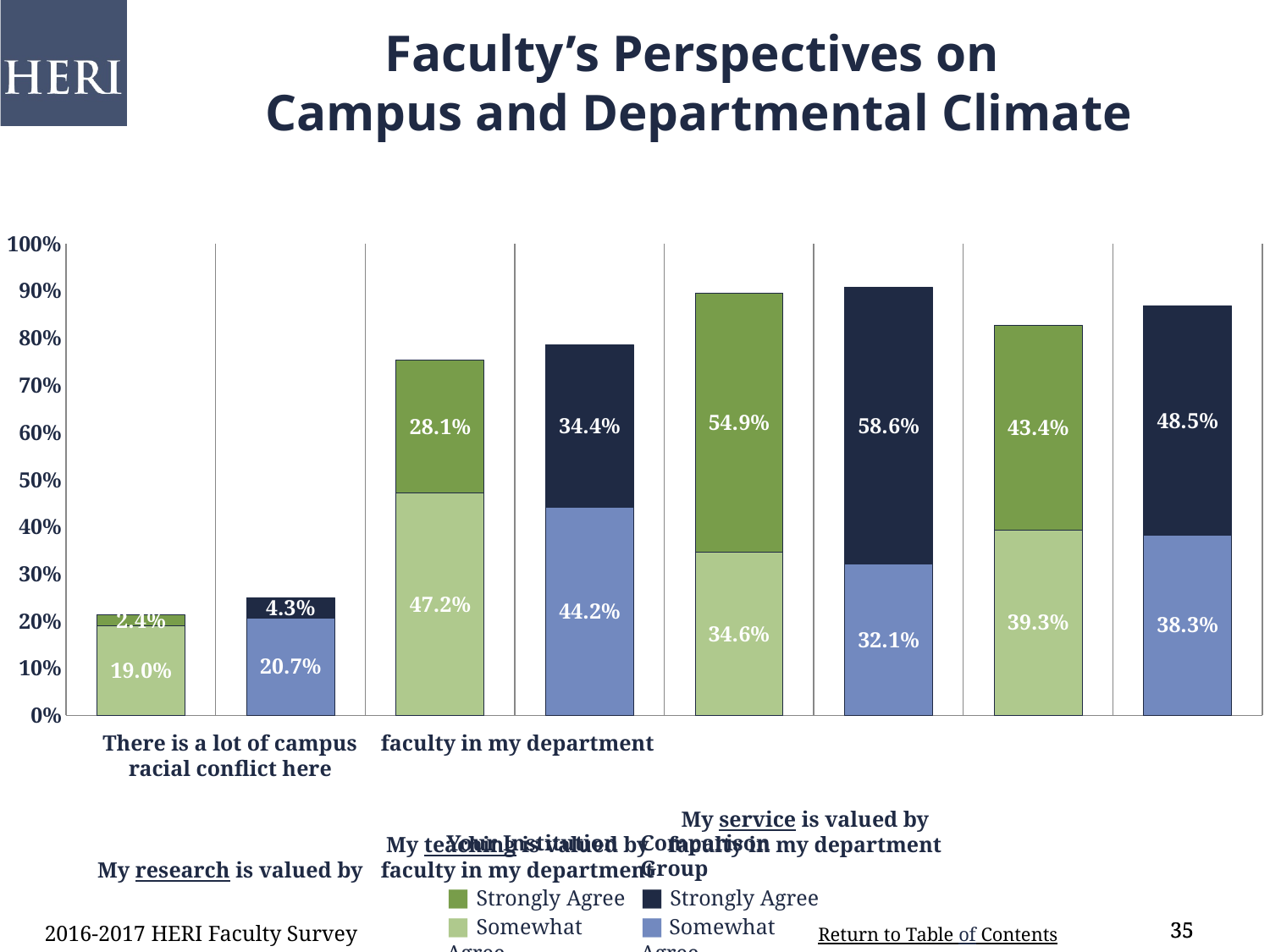
What is the title of the slide's chart? Faculty's Perspectives on Campus and Departmental Climate What percentage of Your Institution faculty strongly agree that their teaching is valued by faculty in their department? 54.9% What percentage of Comparison Group faculty strongly agree that there is a lot of campus racial conflict? 4.3% What percentage of Comparison Group faculty somewhat agree that their research is valued by faculty in their department? 44.2% Which group has the larger 'Strongly Agree' percentage for 'My research is valued by faculty in my department', Your Institution or the Comparison Group? Comparison Group What is the total percentage of Your Institution faculty who agree (strongly or somewhat) that their research is valued by faculty in their department? 75.3% What type of chart is shown on the slide? stacked bar chart Which statement has the lowest total agreement for Your Institution? There is a lot of campus racial conflict here What is the total percentage of Comparison Group faculty who agree (strongly or somewhat) that their teaching is valued by faculty in their department? 90.7% What percentage of Your Institution faculty somewhat agree that their service is valued by faculty in their department? 39.3% How many entries does the legend list? 4 What is the difference between the Comparison Group and Your Institution 'Strongly Agree' percentages for 'My service is valued by faculty in my department'? 5.1%